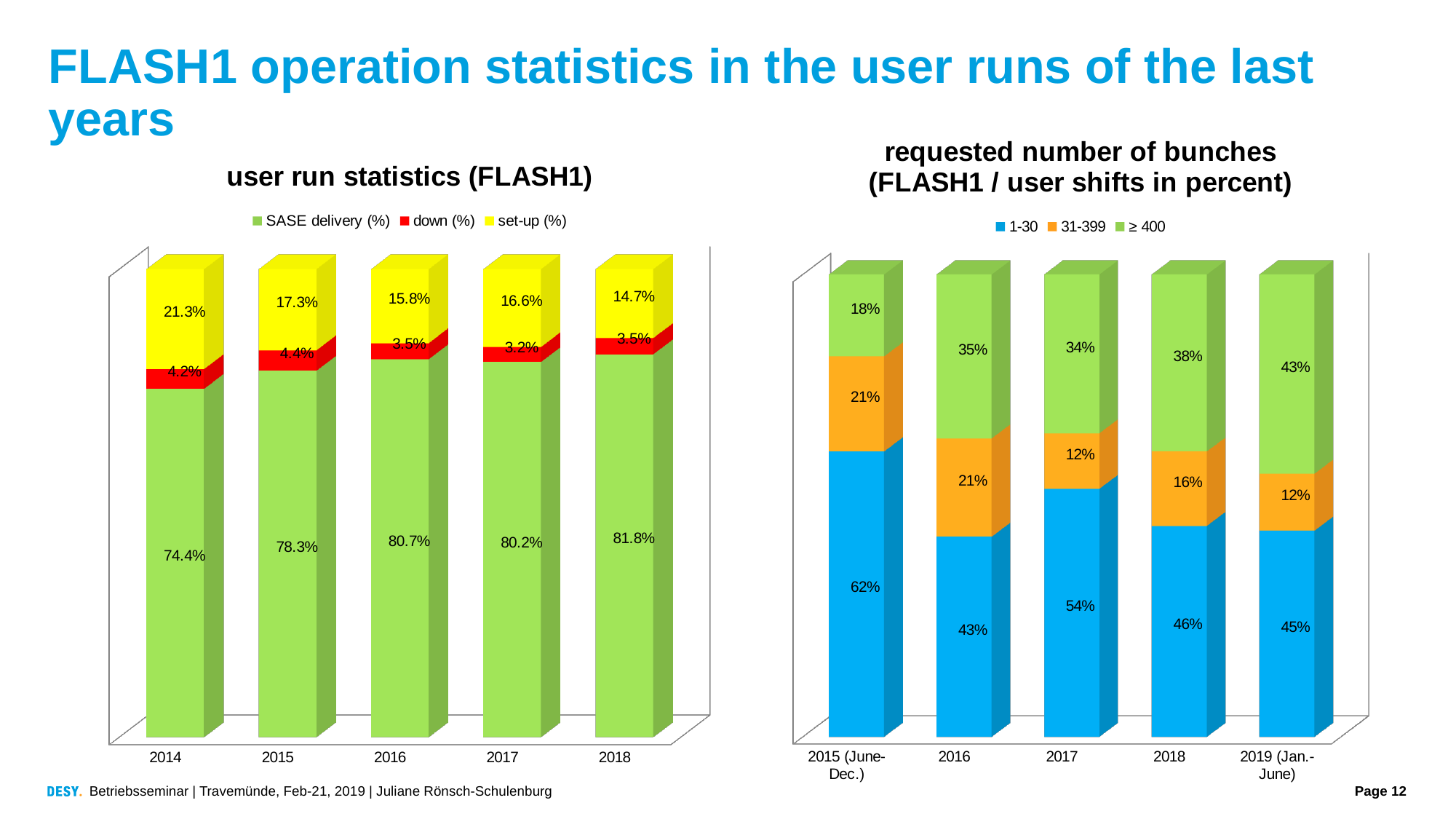
In the 'user run statistics (FLASH1)' chart, which year has the highest SASE delivery (%) value? 2018 In the 'requested number of bunches' chart, which category has the highest 1-30 value? 2015 (June-Dec.) How many series does the legend of the 'user run statistics (FLASH1)' chart list? 3 How many categories are shown on the x axis of the 'requested number of bunches' chart? 5 In the 'requested number of bunches' chart, what is the 1-30 value for 2017? 54% In the 'user run statistics (FLASH1)' chart, what is the difference between the set-up (%) values for 2014 and 2018? 6.6% In the 'requested number of bunches' chart, is the 31-399 value larger for 2016 or for 2018? 2016 In the 'requested number of bunches' chart, what is the ≥ 400 value for 2019 (Jan.-June)? 43% In the 'user run statistics (FLASH1)' chart, what is the SASE delivery (%) value for 2016? 80.7% In the 'user run statistics (FLASH1)' chart, what is the set-up (%) value for 2014? 21.3% What kind of chart is the 'requested number of bunches' chart? Stacked bar chart In the 'user run statistics (FLASH1)' chart, which year has the lowest down (%) value? 2017